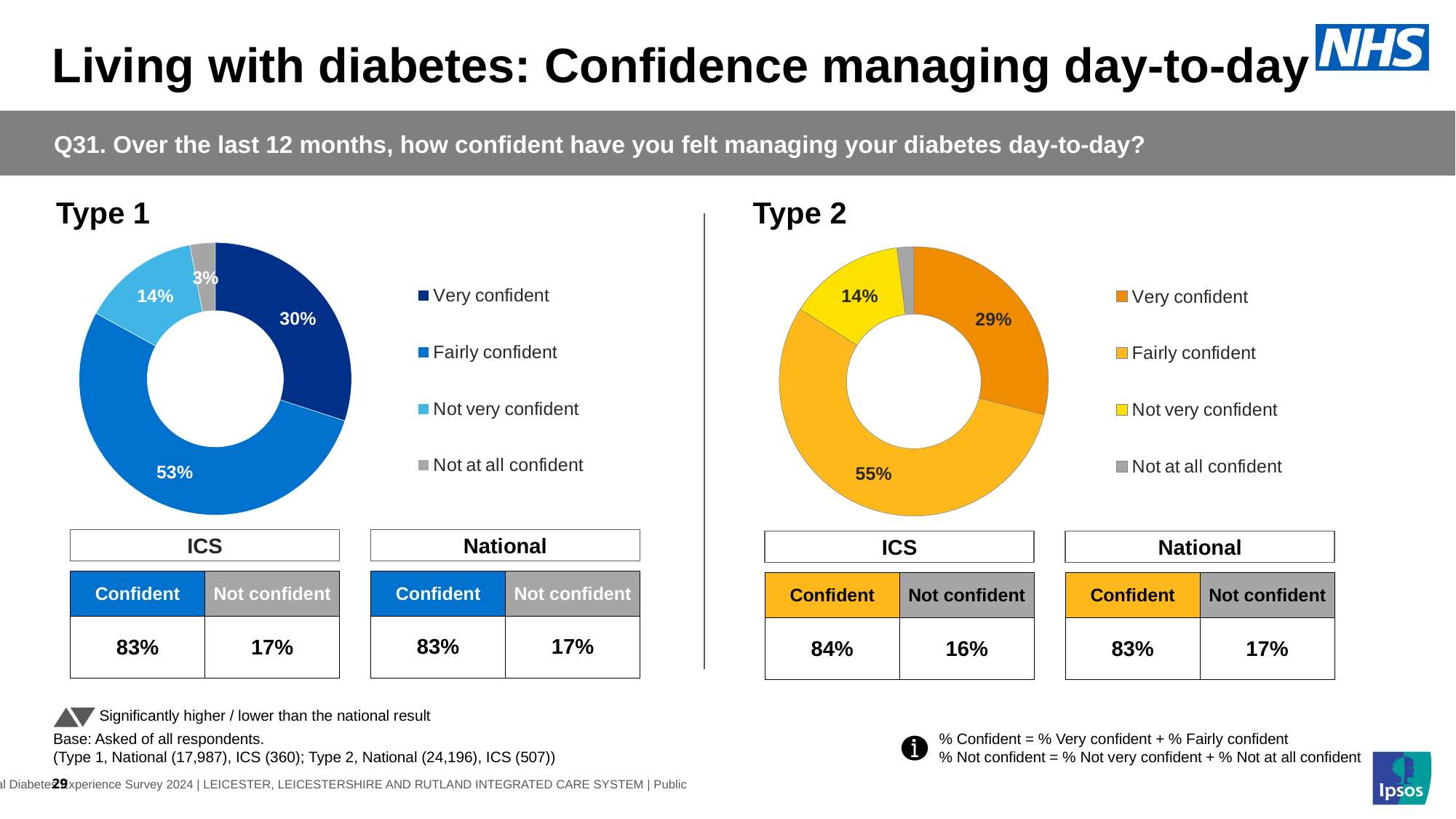
In the Type 1 chart, which category has the smallest share? Not at all confident In the Type 1 chart, what percentage of respondents were Very confident? 30% In the Type 1 chart, what is the difference between the Fairly confident and Very confident shares? 23 percentage points In the Type 1 chart, which category has the largest share? Fairly confident What kind of chart is used for Type 1? Doughnut (pie) chart In the Type 2 chart, what percentage of respondents were Very confident? 29% In the Type 2 chart, which category has the largest share? Fairly confident In the Type 1 chart, what percentage of respondents were Fairly confident? 53% In the Type 1 chart, what percentage of respondents were Not very confident? 14% In the Type 2 chart, which is larger: the Very confident share or the Not very confident share? Very confident How many categories does the legend of the Type 2 chart list? 4 In the Type 2 chart, what percentage of respondents were Fairly confident? 55%